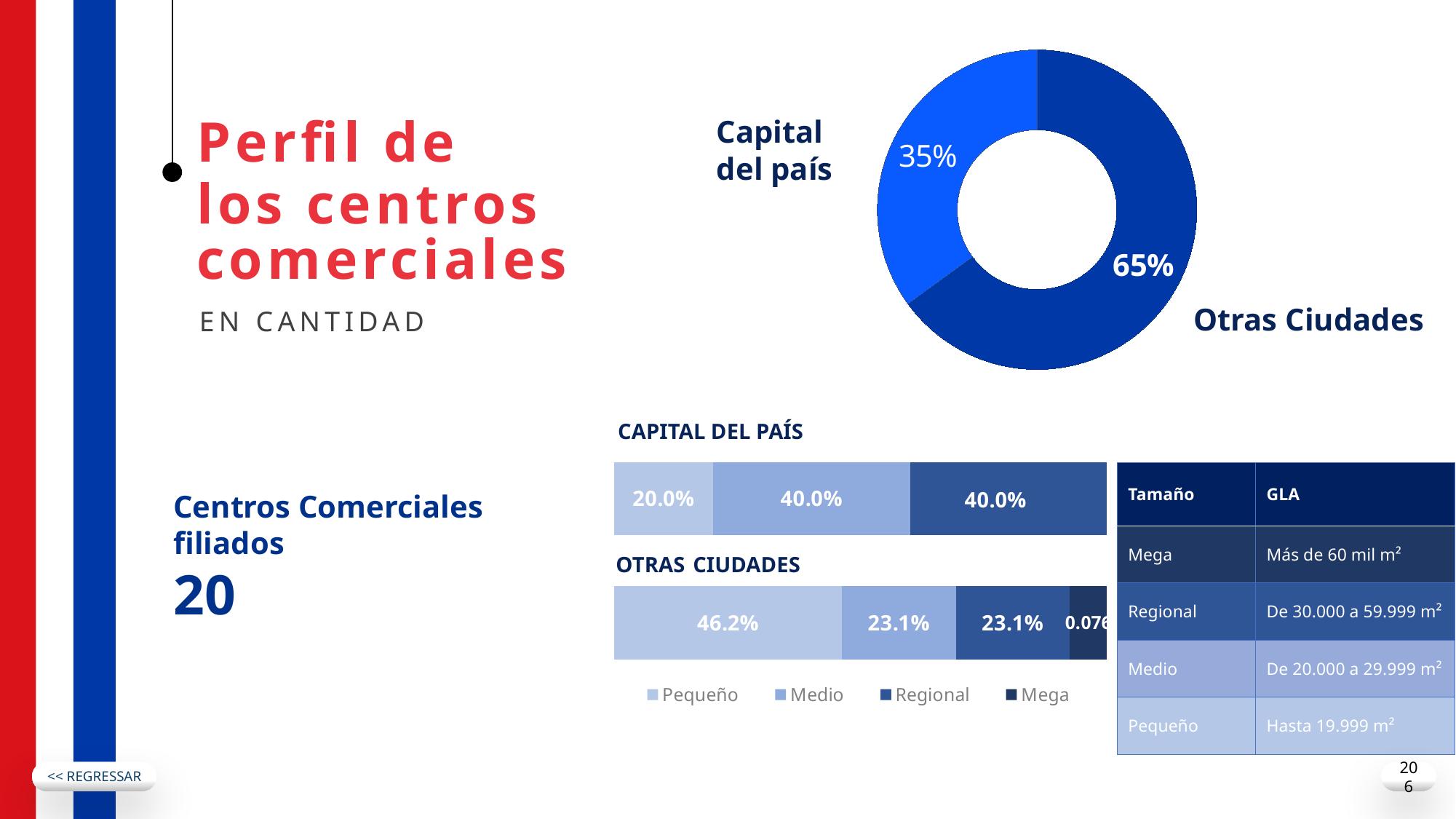
In the donut chart at the top, what share is labelled for Capital del país? 35% In the stacked bar chart, what is the Medio share for Capital del País? 40.0% In the stacked bar chart, how many series does the legend list? 4 In the stacked bar chart, what is the difference between the Pequeño share for Otras Ciudades and the Pequeño share for Capital del País? 26.2 percentage points In the stacked bar chart, what is the Pequeño share for Otras Ciudades? 46.2% In the donut chart at the top, what is the difference in percentage points between Otras Ciudades and Capital del país? 30 In the donut chart at the top, which segment is larger, Capital del país or Otras Ciudades? Otras Ciudades In the stacked bar chart, what is the Pequeño share for Capital del País? 20.0% In the stacked bar chart, what is the Regional share for Otras Ciudades? 23.1% What kind of chart is the chart at the top of the slide? Donut (pie) chart In the stacked bar chart, which segment is the largest in the Otras Ciudades bar? Pequeño In the donut chart at the top, what share is labelled for Otras Ciudades? 65%